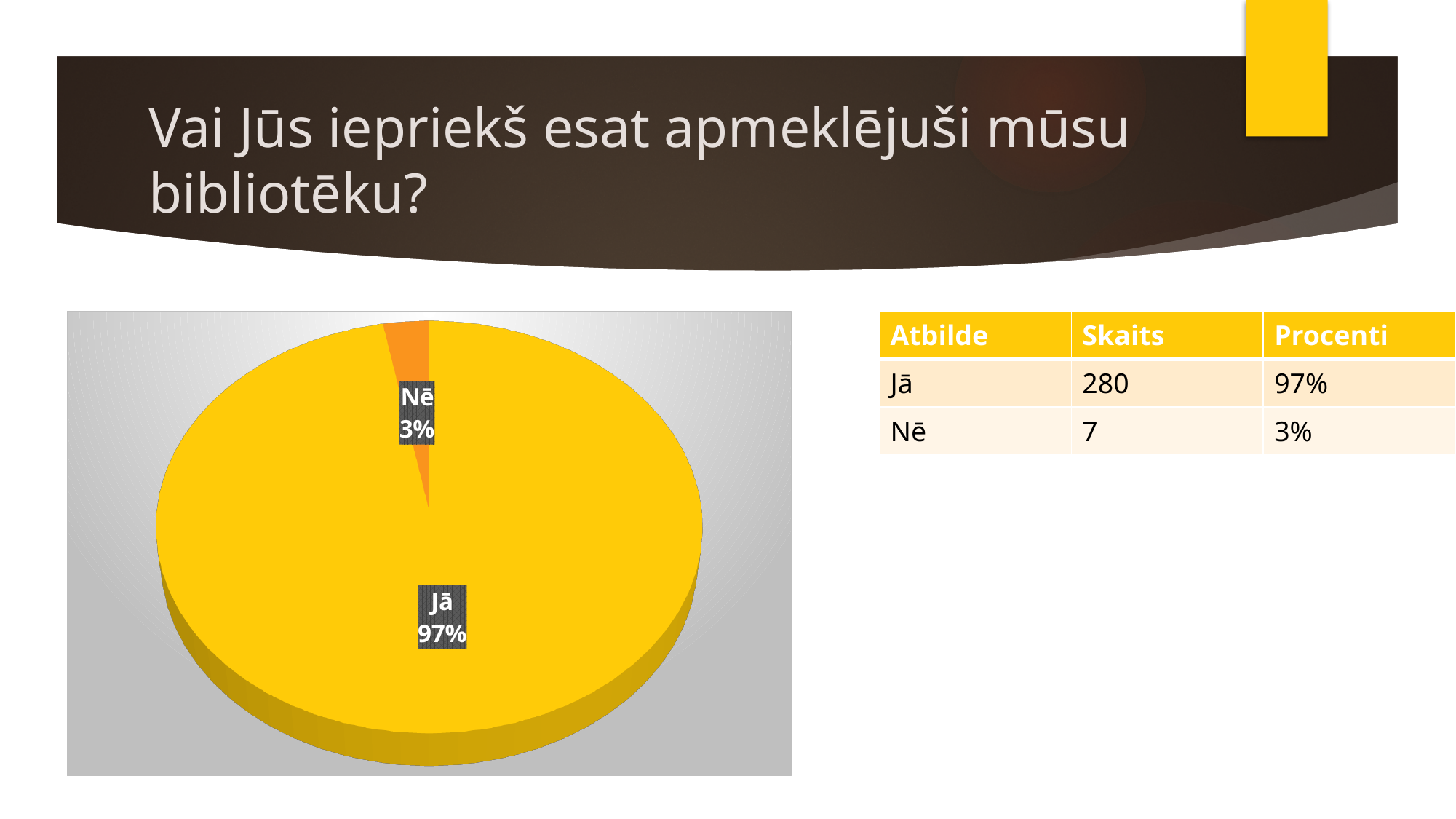
What share of the pie does the "Nē" slice represent? 3% What colour is the "Jā" slice in the pie chart? yellow How many slices does the pie chart have? 2 What colour is the "Nē" slice in the pie chart? orange What is the difference in percentage points between the "Jā" slice and the "Nē" slice? 94 What share of the pie does the "Jā" slice represent? 97% What kind of chart is shown on the slide? pie chart Which slice of the pie chart is the largest? Jā Which is larger in the pie chart, the "Jā" slice or the "Nē" slice? Jā Which slice of the pie chart is the smallest? Nē